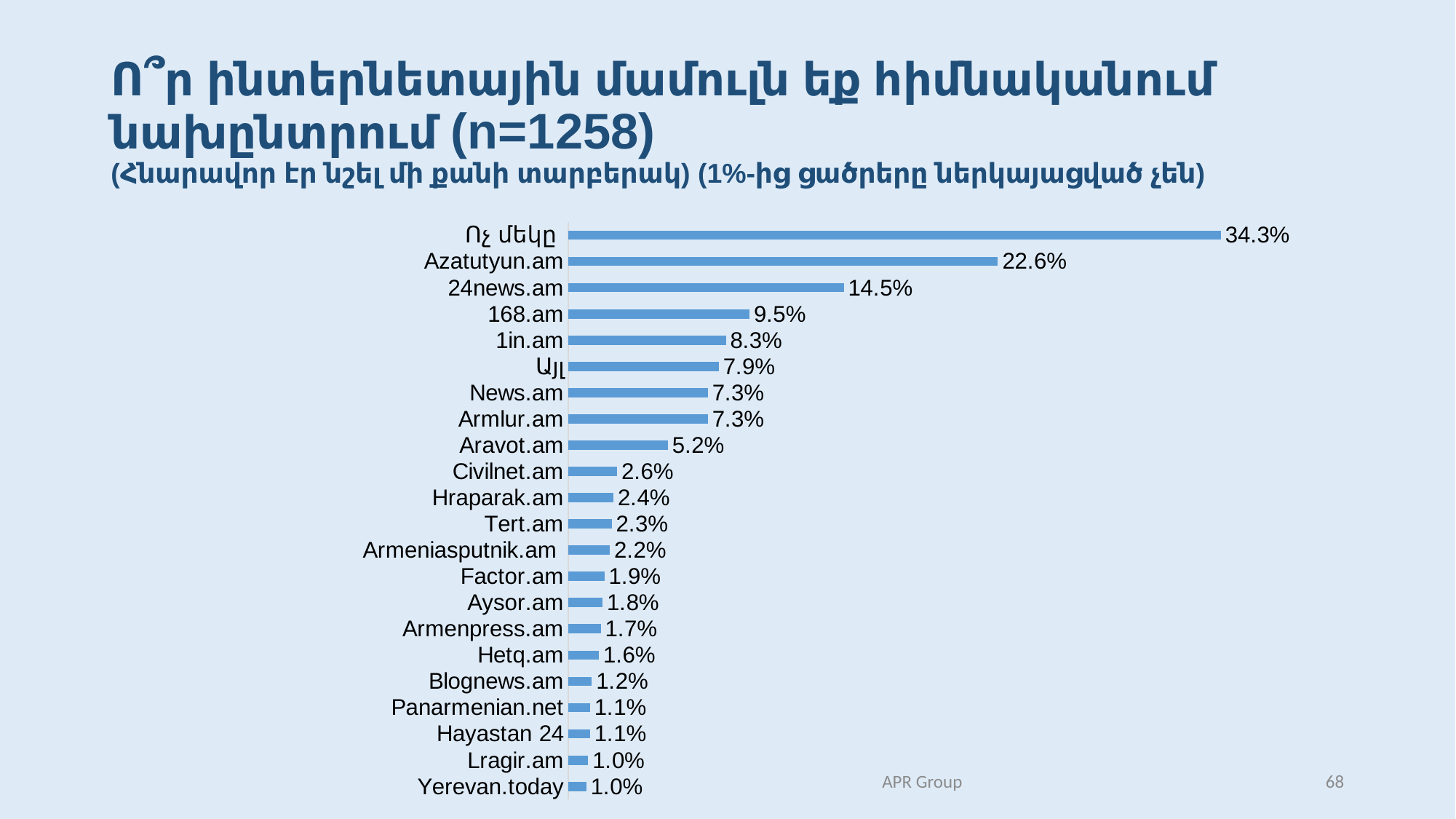
What is the value for Hetq.am? 1.6% What is the value for Azatutyun.am? 22.6% Which category has the lowest value among the named news sites, excluding ties with Lragir.am? Yerevan.today How many categories are shown in the chart? 22 What is the difference between the values for Ոչ մեկը and Azatutyun.am? 11.7% What kind of chart is shown on the slide? bar chart What is the value for Aravot.am? 5.2% What is the difference between the values for Azatutyun.am and 24news.am? 8.1% What is the sample size (n) stated in the chart title? 1258 What is the value for 168.am? 9.5% Which is larger, the value for 1in.am or the value for News.am? 1in.am Which category has the highest value? Ոչ մեկը